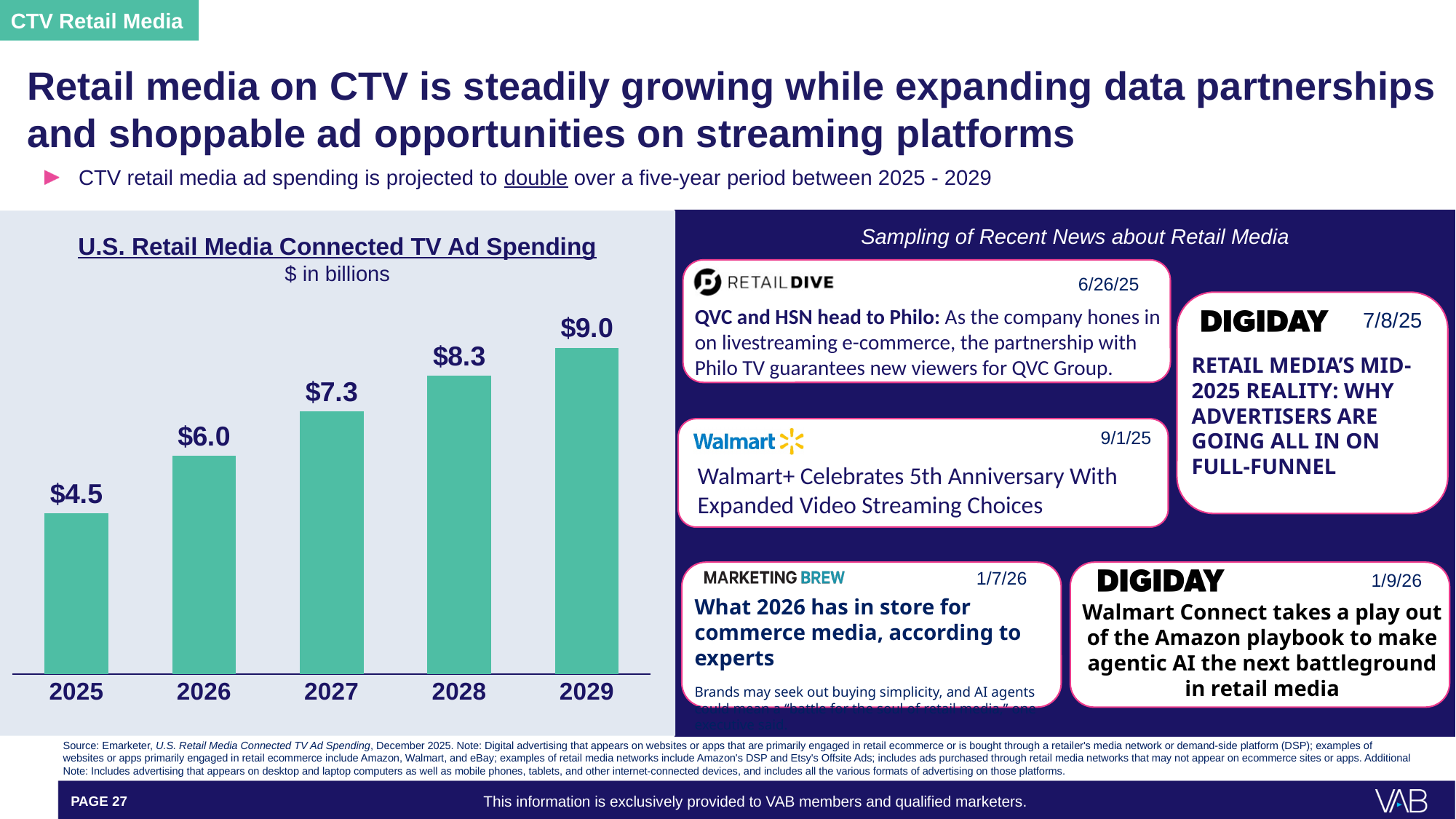
Which year has the highest value in the U.S. Retail Media Connected TV Ad Spending chart? 2029 In what unit are the values in the U.S. Retail Media Connected TV Ad Spending chart expressed? $ in billions Which is larger in the chart, the value for 2026 or the value for 2028? 2028 Which year has the lowest value in the chart? 2025 What is the value shown for 2027 in the U.S. Retail Media Connected TV Ad Spending chart? $7.3 What is the value shown for 2029 in the chart? $9.0 How many years are plotted in the U.S. Retail Media Connected TV Ad Spending chart? 5 What is the difference between the 2028 and 2027 values in the chart? $1.0 What is the difference between the 2029 and 2025 values in the chart? $4.5 What is the U.S. retail media connected TV ad spending value shown for 2025? $4.5 Do the values in the chart rise or fall from 2025 to 2029? Rise What kind of chart is used to show U.S. Retail Media Connected TV Ad Spending? Bar chart